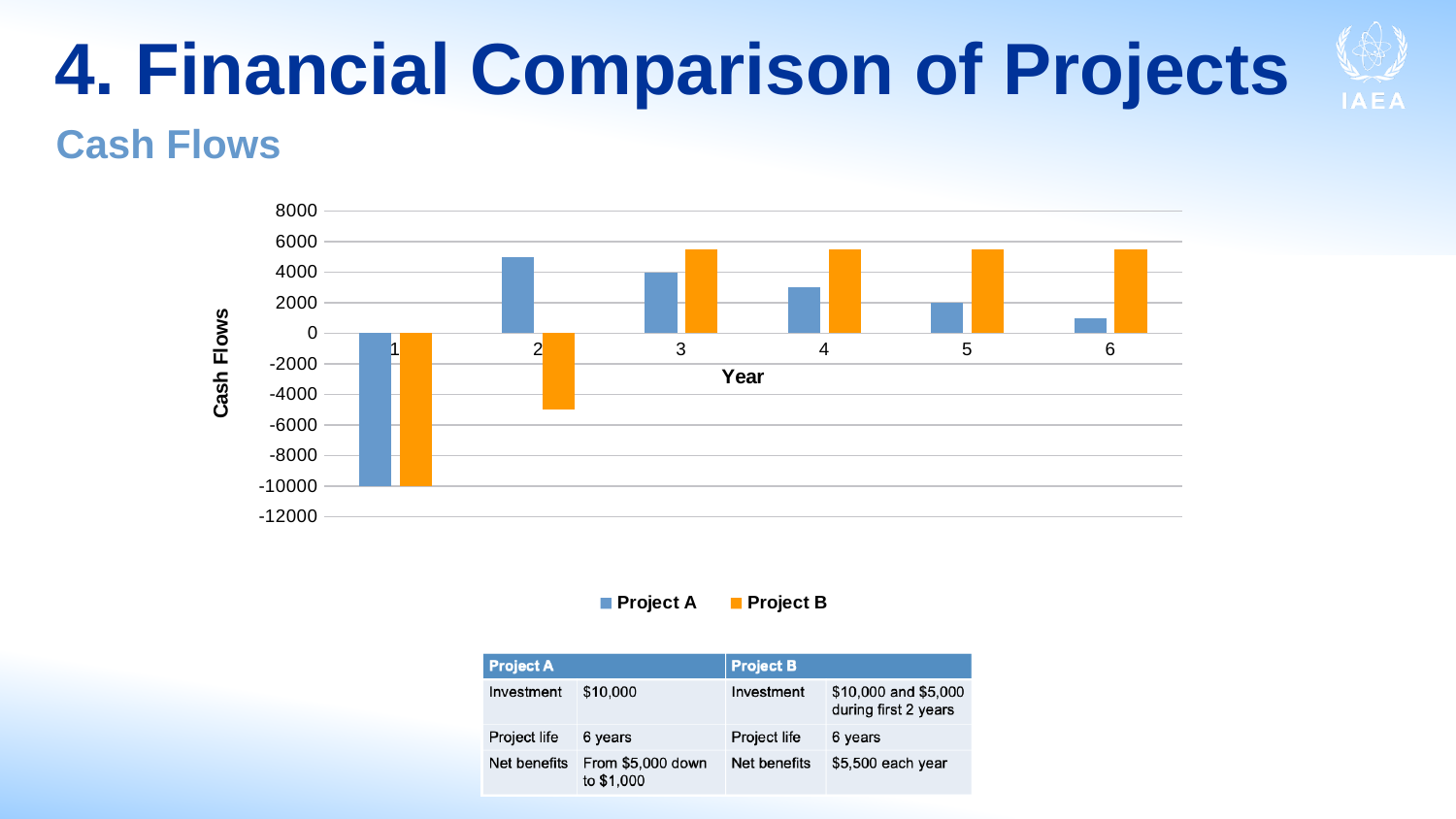
What type of chart is shown on the slide? bar chart Is the cash flow for Project B in year 4 greater or less than 4000? greater What colour represents Project B in the chart? orange How many series does the chart legend list? 2 What is the cash flow for Project A in year 5? 2000 Is the cash flow for Project B in year 2 greater or less than -4000? less Do the cash flows for Project A rise or fall from year 2 to year 6? fall What is the cash flow for Project A in year 1? -10000 Which project has the larger cash flow in year 2, Project A or Project B? Project A Is the cash flow for Project A in year 6 greater or less than 2000? less How many years are shown on the x axis of the chart? 6 What is the cash flow for Project A in year 3? 4000